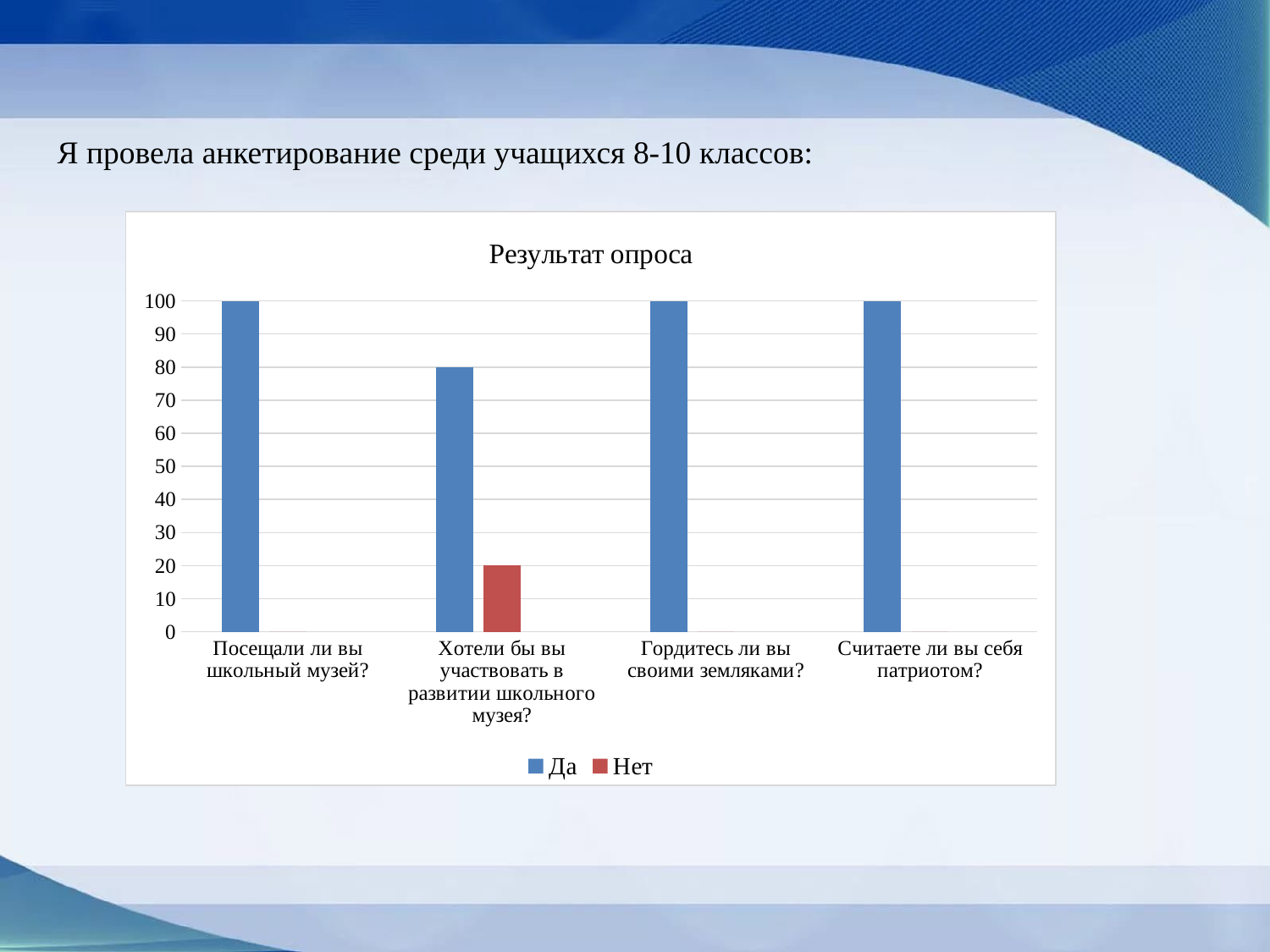
Which legend entry is shown in red? Нет What is the title of the chart? Результат опроса What is the value of "Да" for "Хотели бы вы участвовать в развитии школьного музея?"? 80 How many series does the legend list? 2 What is the value of "Да" for "Посещали ли вы школьный музей?"? 100 What is the value of "Нет" for "Хотели бы вы участвовать в развитии школьного музея?"? 20 Is the "Да" value for "Гордитесь ли вы своими земляками?" greater or less than 50? greater Which category has the lowest value for "Да"? Хотели бы вы участвовать в развитии школьного музея? What is the difference between the "Да" and "Нет" values for "Хотели бы вы участвовать в развитии школьного музея?"? 60 How many question categories are shown on the x axis? 4 Which is larger for "Хотели бы вы участвовать в развитии школьного музея?": the "Да" value or the "Нет" value? Да What kind of chart is shown on the slide? bar chart